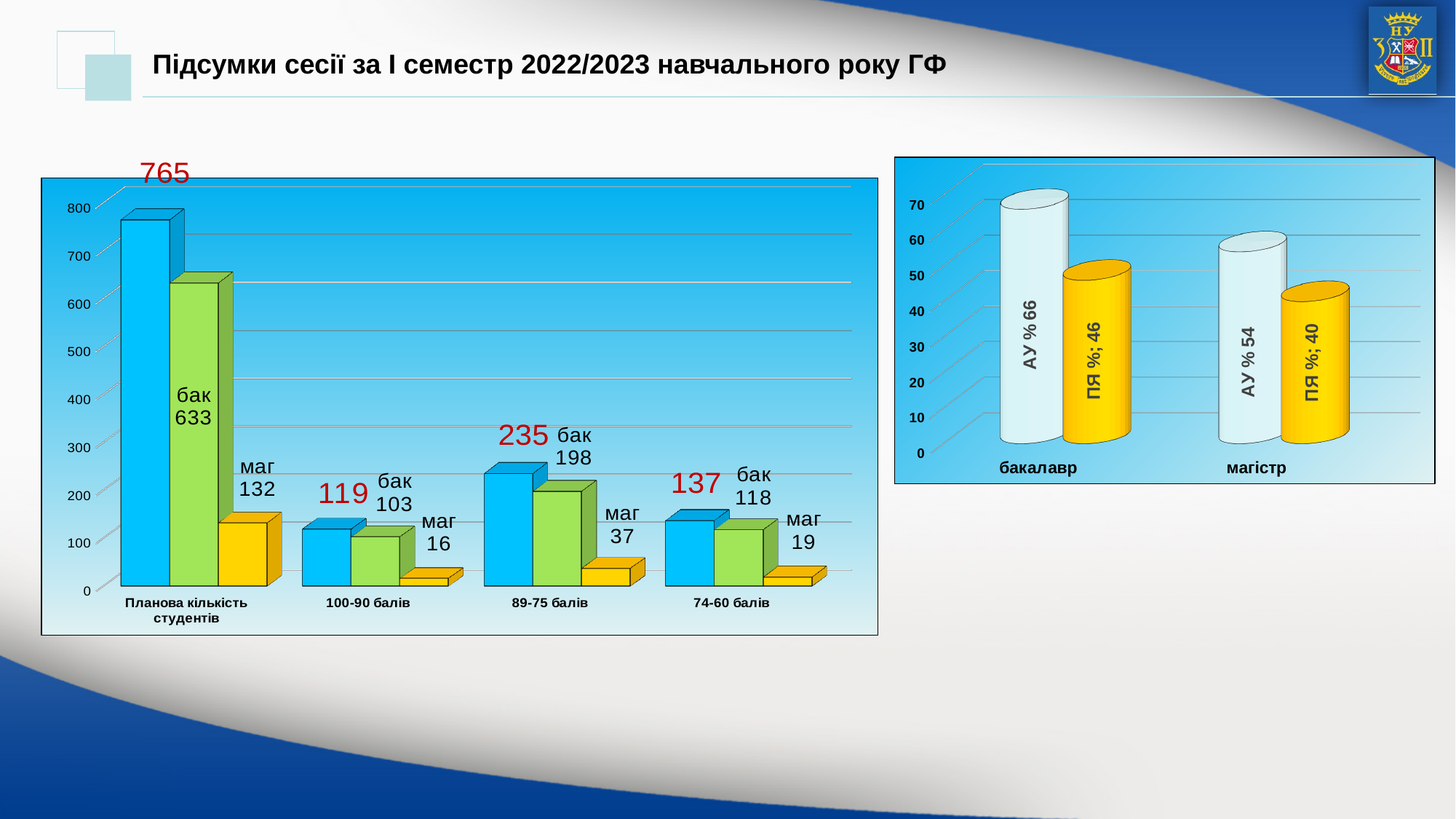
On the left chart, what is the difference between the 'бак' and 'маг' values for 'Планова кількість студентів'? 501 On the left chart, what is the total value shown for 'Планова кількість студентів'? 765 On the left chart, which is larger: the total for '89-75 балів' or the total for '74-60 балів'? 89-75 балів On the right chart, what is the 'АУ %' value for 'бакалавр'? 66 What type of chart is the left chart? bar chart On the right chart, what is the difference between the 'АУ %' values for 'бакалавр' and 'магістр'? 12 On the left chart, what is the 'бак' value for '89-75 балів'? 198 On the left chart, which category has the lowest total value? 100-90 балів On the left chart, what is the 'маг' value for '100-90 балів'? 16 How many categories are shown on the x axis of the left chart? 4 On the left chart, what is the total value shown for '74-60 балів'? 137 On the right chart, what is the 'ПЯ %' value for 'магістр'? 40